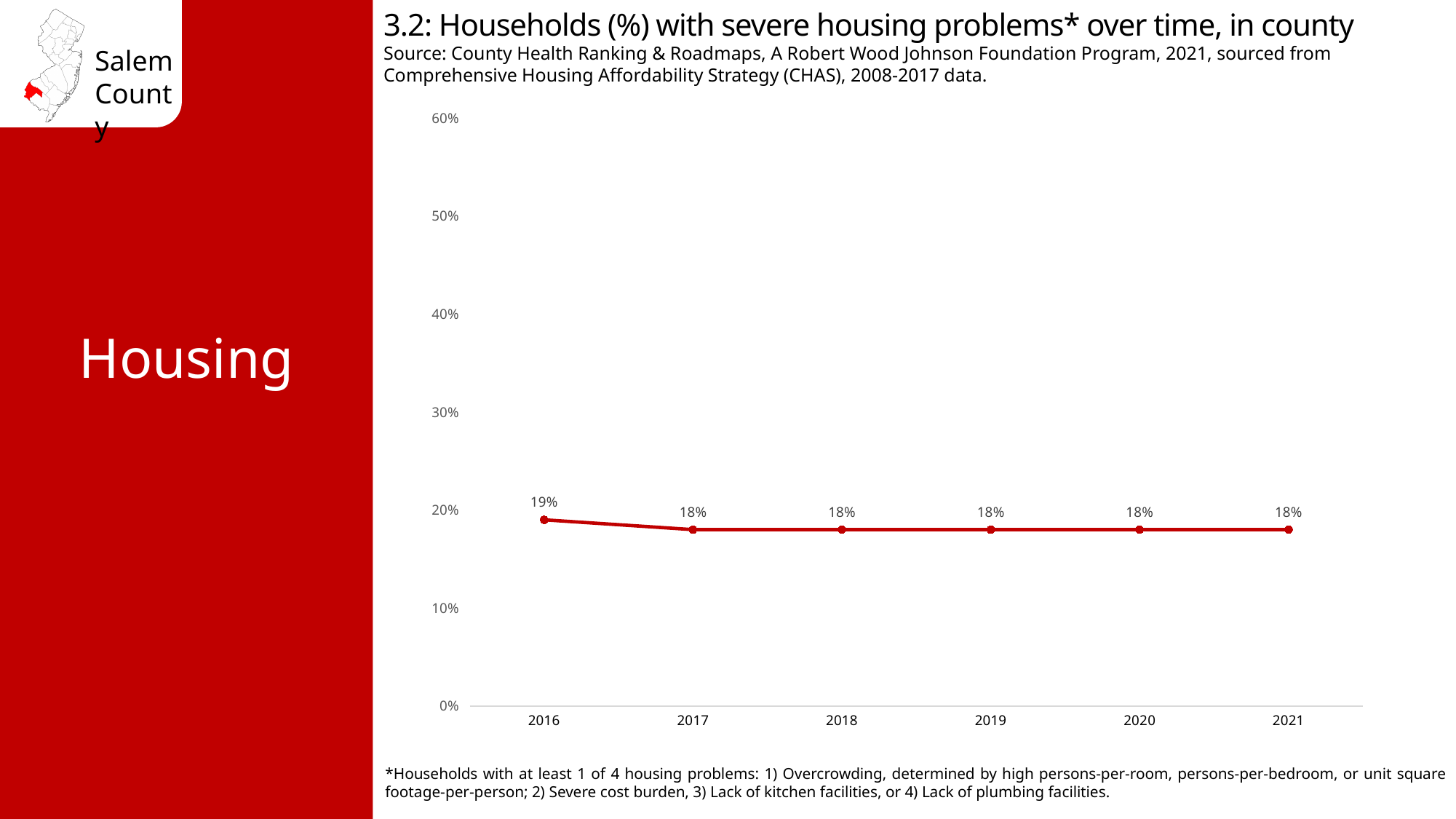
Is the value for 2016 larger or smaller than the value for 2020? larger What is the value shown for 2018? 18% What is the title of the chart? 3.2: Households (%) with severe housing problems* over time, in county Is the value for 2019 greater or less than 30%? less What is the highest value shown on the y axis? 60% Which year has the highest percentage of households with severe housing problems? 2016 What percentage of households had severe housing problems in 2021? 18% What kind of chart is shown on the slide? line chart Does the percentage of households with severe housing problems rise, fall, or stay flat from 2017 to 2021? stay flat What percentage of households had severe housing problems in 2016? 19% What is the difference between the 2016 value and the 2017 value? 1% How many years are plotted on the chart? 6